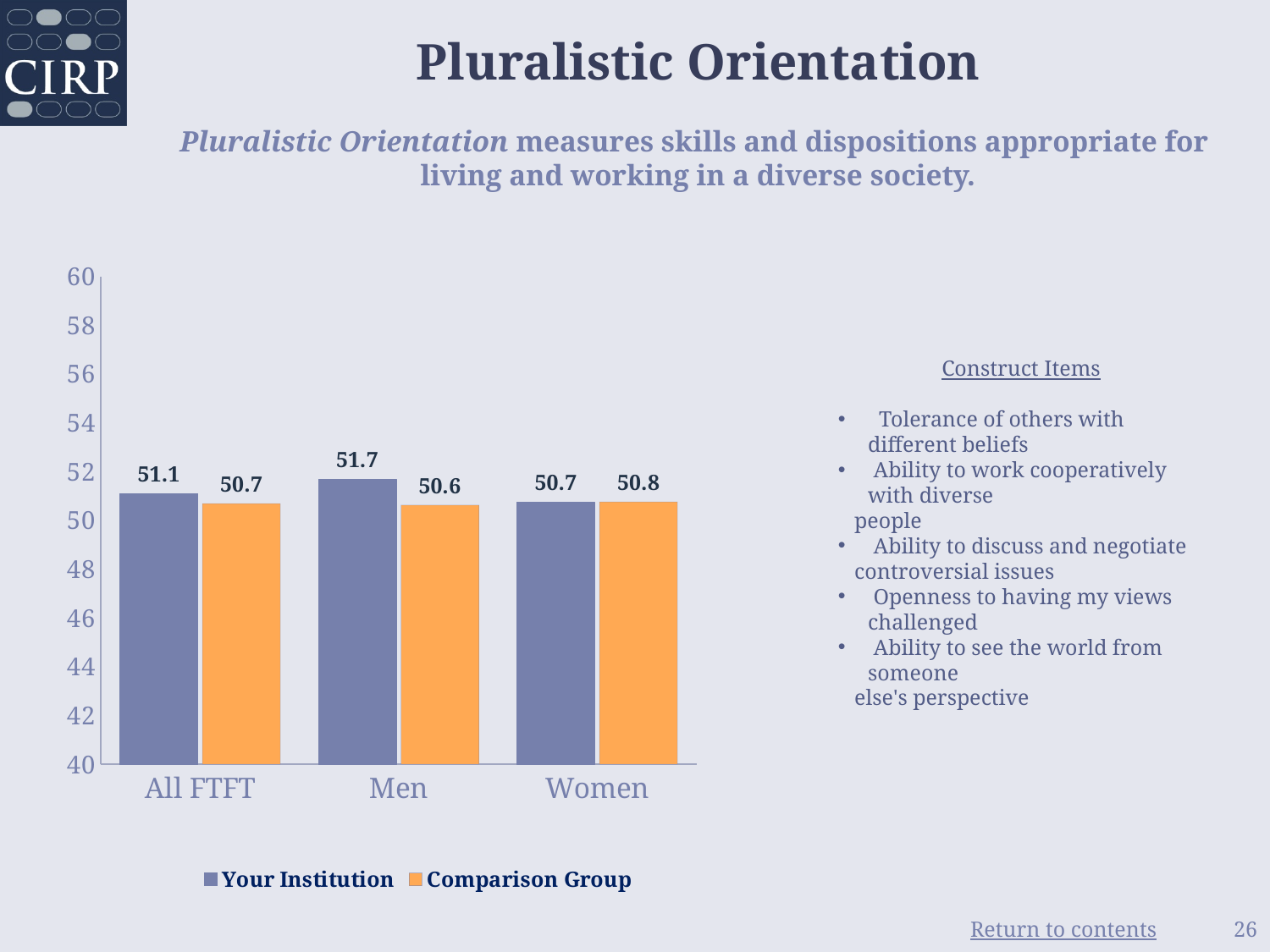
What is the Comparison Group value for Men? 50.6 What is the Your Institution value for Men? 51.7 How many series does the legend list? 2 Which series is shown in orange in the legend? Comparison Group What is the Your Institution value for All FTFT? 51.1 How many categories are shown on the x axis? 3 What is the difference between the Your Institution and Comparison Group values for Men? 1.1 For All FTFT, which is larger: Your Institution or Comparison Group? Your Institution What is the Comparison Group value for Women? 50.8 What kind of chart is shown on the slide? Bar chart Which category has the highest Your Institution value? Men Which category has the lowest Comparison Group value? Men